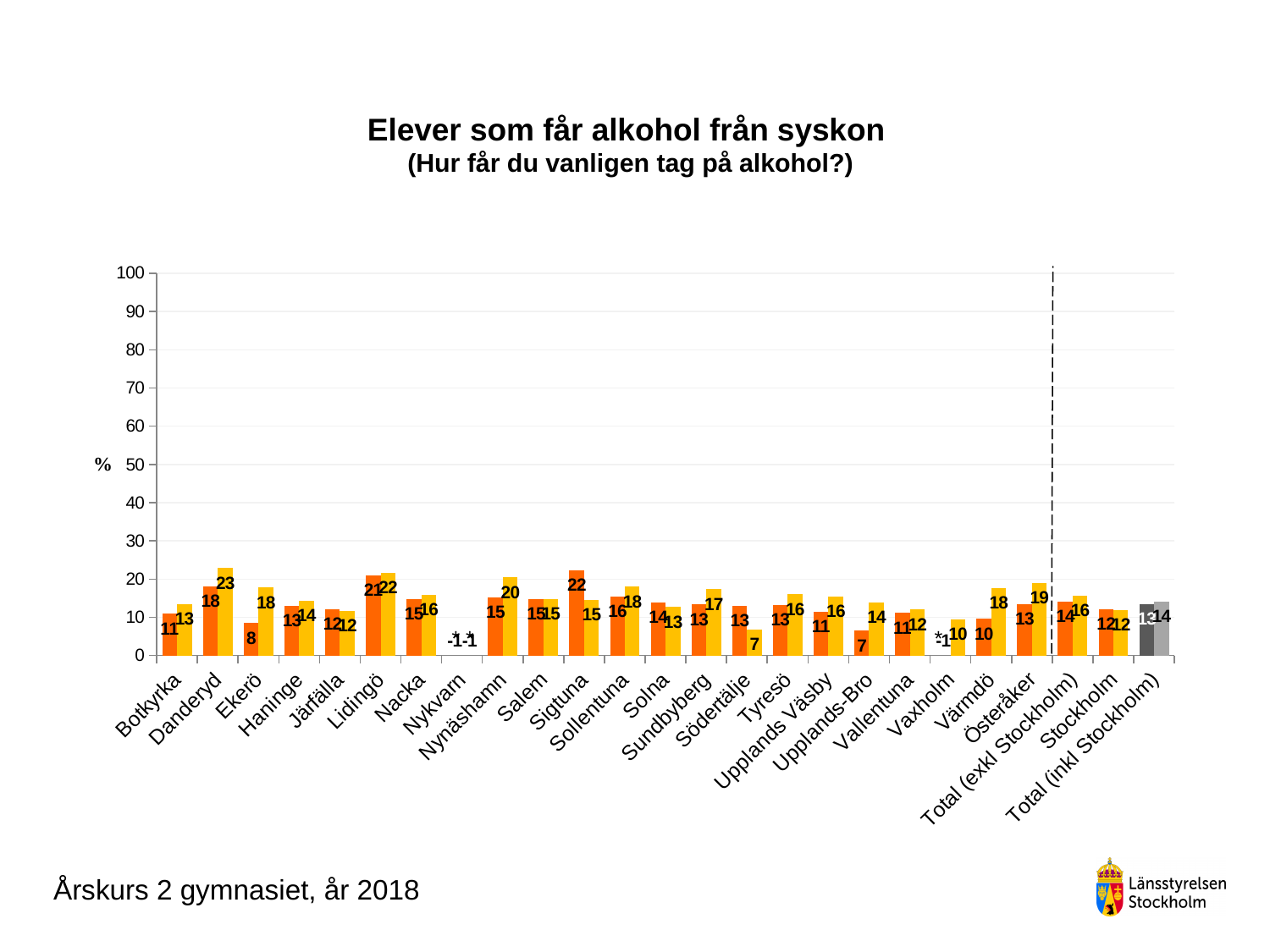
What is the value of the yellow (right) bar for Danderyd? 23 What is the value of the orange (left) bar for Ekerö? 8 Is the value of the yellow (right) bar for Lidingö greater or less than 30? less What is the difference between the yellow (right) bar and the orange (left) bar for Ekerö? 10 How many categories are shown along the x axis of the chart? 25 What type of chart is shown on the slide? bar chart What is the title of the chart? Elever som får alkohol från syskon What is the value of the yellow (right) bar for Total (inkl Stockholm)? 14 Which is larger for Södertälje, the orange (left) bar or the yellow (right) bar? the orange (left) bar What is the value of the orange (left) bar for Sigtuna? 22 Which category has the highest yellow (right) bar? Danderyd What is the value of the orange (left) bar for Upplands-Bro? 7